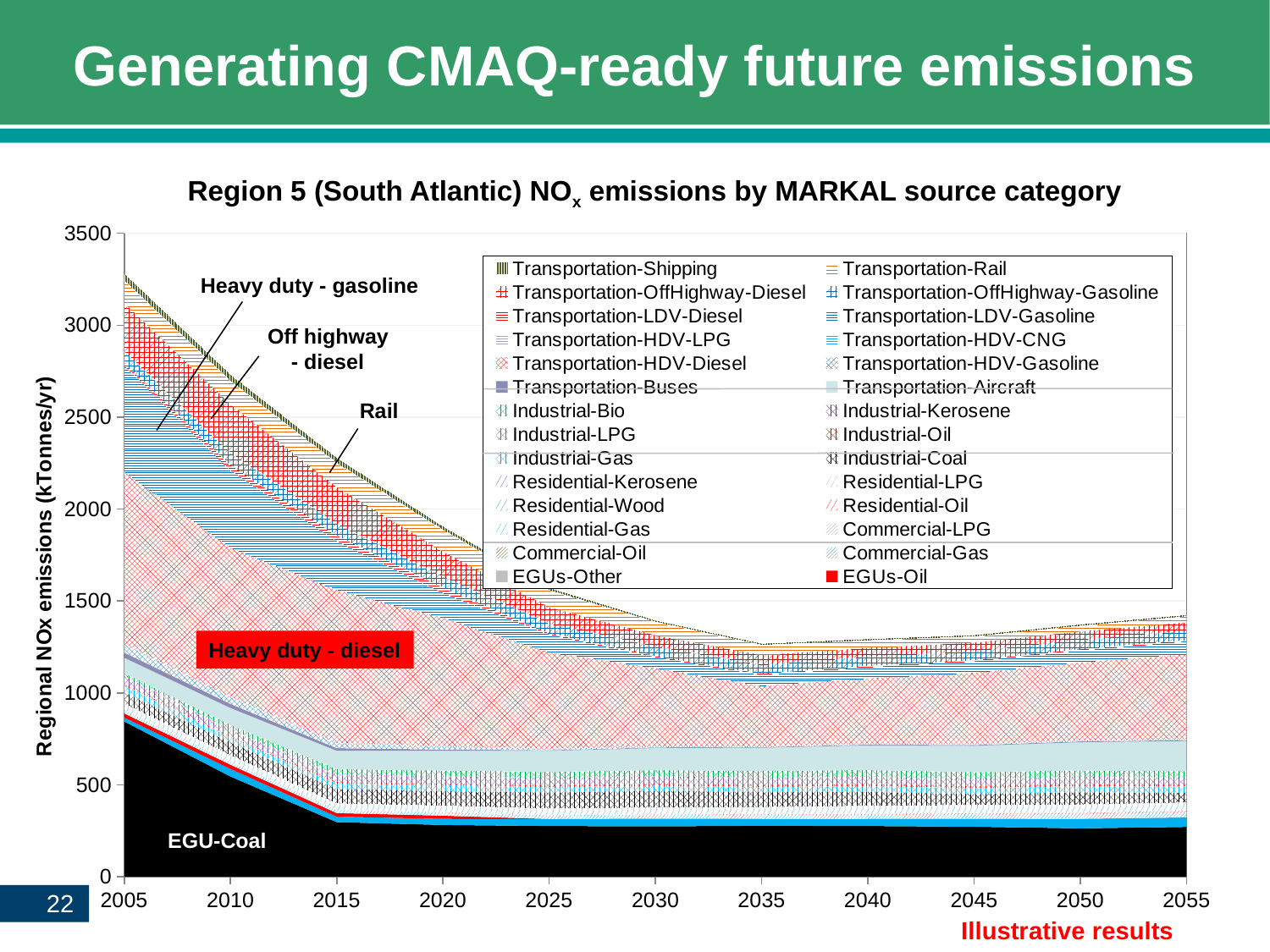
Is the EGU-Coal value in 2015 greater or less than 500? less What is the title of the chart? Region 5 (South Atlantic) NOx emissions by MARKAL source category Do total NOx emissions rise or fall between 2005 and 2035? fall Is the total NOx emissions value in 2035 greater or less than 1500? less Is the EGU-Coal value in 2005 greater or less than 500? greater Which is larger, the total NOx emissions in 2005 or in 2055? 2005 Which year has the highest total NOx emissions? 2005 How many year ticks are shown on the x axis? 11 How many series does the legend list? 28 What is the label of the vertical axis? Regional NOx emissions (kTonnes/yr) What kind of chart is shown on the slide? Stacked area chart